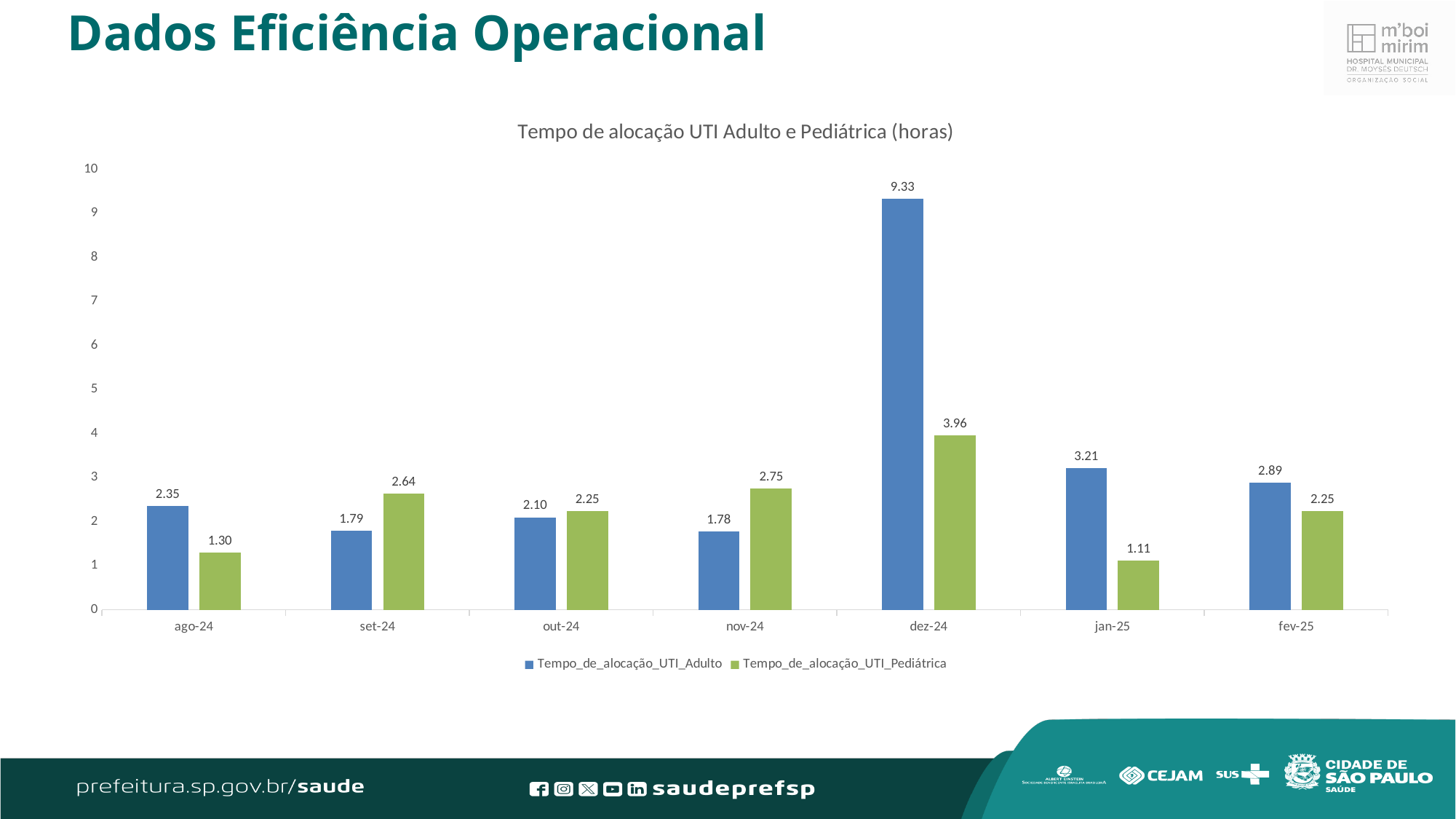
What is the difference between the Tempo_de_alocação_UTI_Adulto and Tempo_de_alocação_UTI_Pediátrica values in dez-24? 5.37 What is the value for Tempo_de_alocação_UTI_Adulto in dez-24? 9.33 What is the value for Tempo_de_alocação_UTI_Adulto in jan-25? 3.21 Which month has the lowest value for Tempo_de_alocação_UTI_Adulto? nov-24 Which month has the highest value for Tempo_de_alocação_UTI_Pediátrica? dez-24 What is the title of the chart? Tempo de alocação UTI Adulto e Pediátrica (horas) What is the value for Tempo_de_alocação_UTI_Pediátrica in ago-24? 1.30 Is the value for Tempo_de_alocação_UTI_Adulto in dez-24 greater or less than 9? greater How many months are shown on the x axis? 7 In set-24, which series has the larger value: Tempo_de_alocação_UTI_Adulto or Tempo_de_alocação_UTI_Pediátrica? Tempo_de_alocação_UTI_Pediátrica How many series does the legend list? 2 What kind of chart is shown on the slide? Bar chart